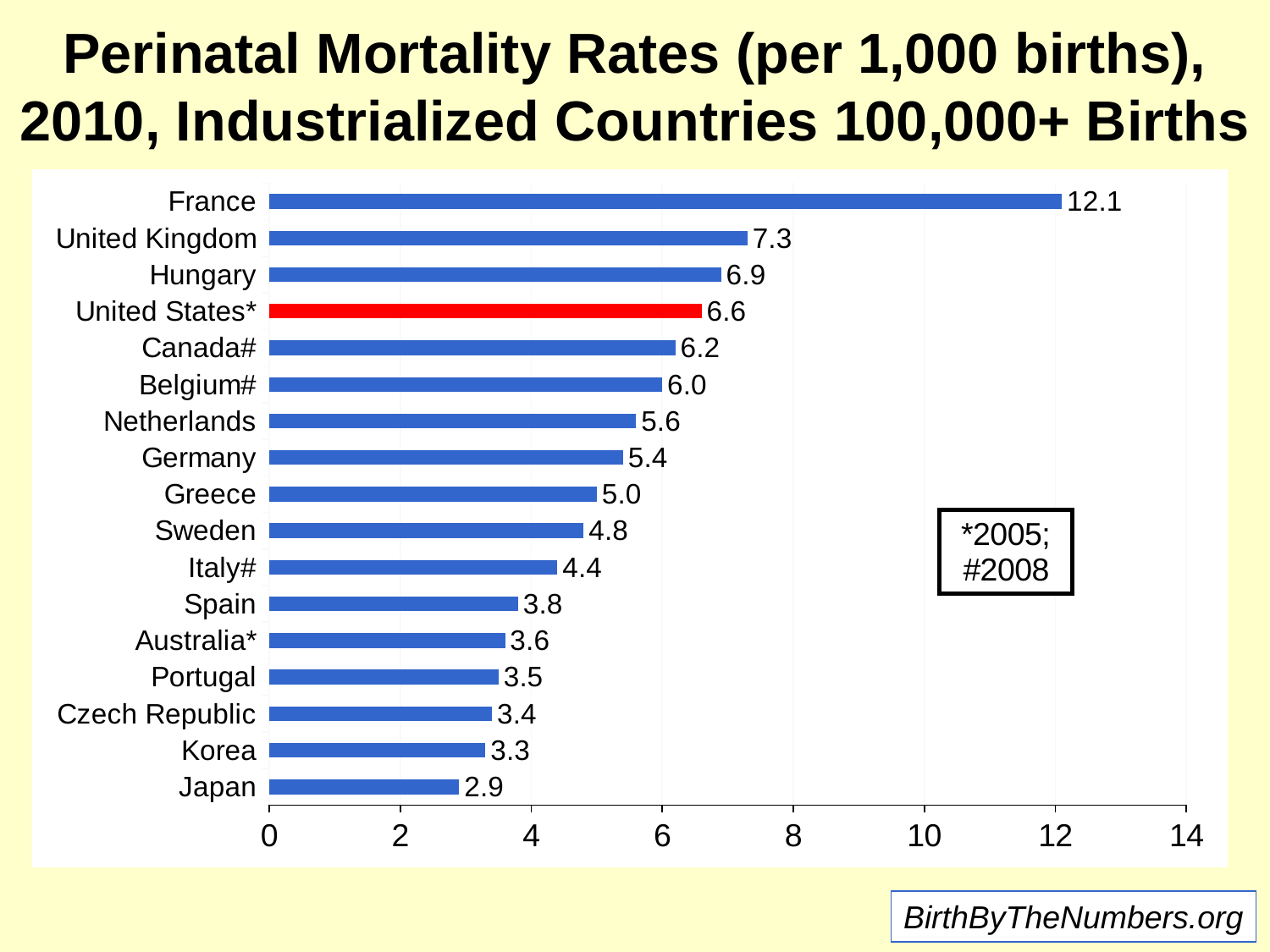
What kind of chart is shown on the slide? Bar chart How many countries are shown in the chart? 17 Which has a higher perinatal mortality rate, Hungary or Canada#? Hungary Which bar is coloured red in the chart? United States* Which country has the lowest perinatal mortality rate? Japan What is the difference between the perinatal mortality rates of France and the United Kingdom? 4.8 What is the perinatal mortality rate for Sweden? 4.8 What is the difference between the perinatal mortality rates of the United States* and Japan? 3.7 What is the perinatal mortality rate for France? 12.1 What is the perinatal mortality rate for Japan? 2.9 What is the perinatal mortality rate for the United States*? 6.6 Which country has the highest perinatal mortality rate? France